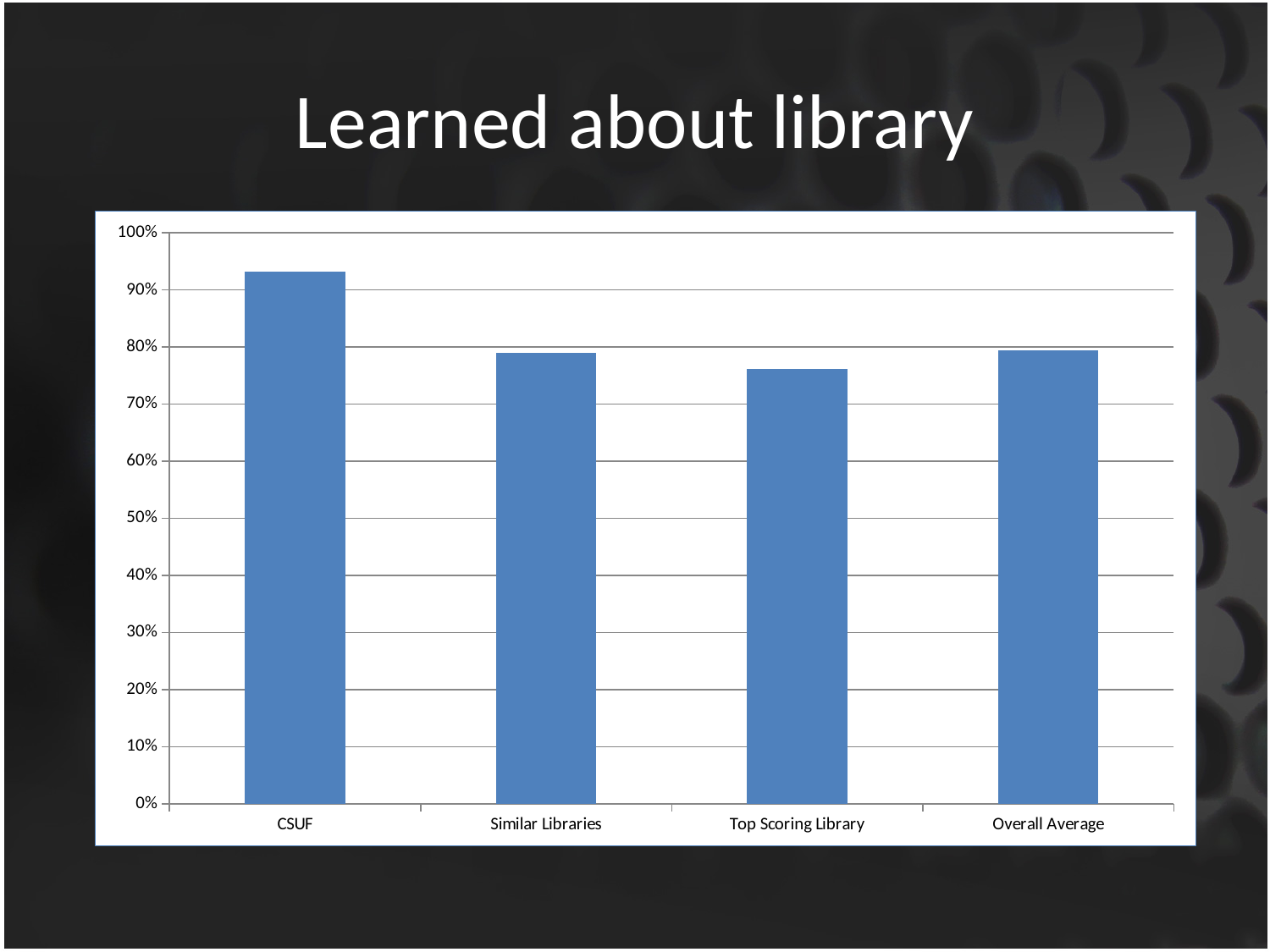
Is the value for Similar Libraries greater or less than 80%? less Is the value for Top Scoring Library greater or less than 70%? greater Which is larger, the value for CSUF or the value for Top Scoring Library? CSUF What is the title of the slide containing the chart? Learned about library Which is larger, the value for CSUF or the value for Overall Average? CSUF How many categories are shown on the x axis of the chart? 4 Which category has the lowest value in the chart? Top Scoring Library Which category has the highest value in the chart? CSUF What kind of chart is shown on the slide? bar chart Is the value for Top Scoring Library greater or less than 80%? less